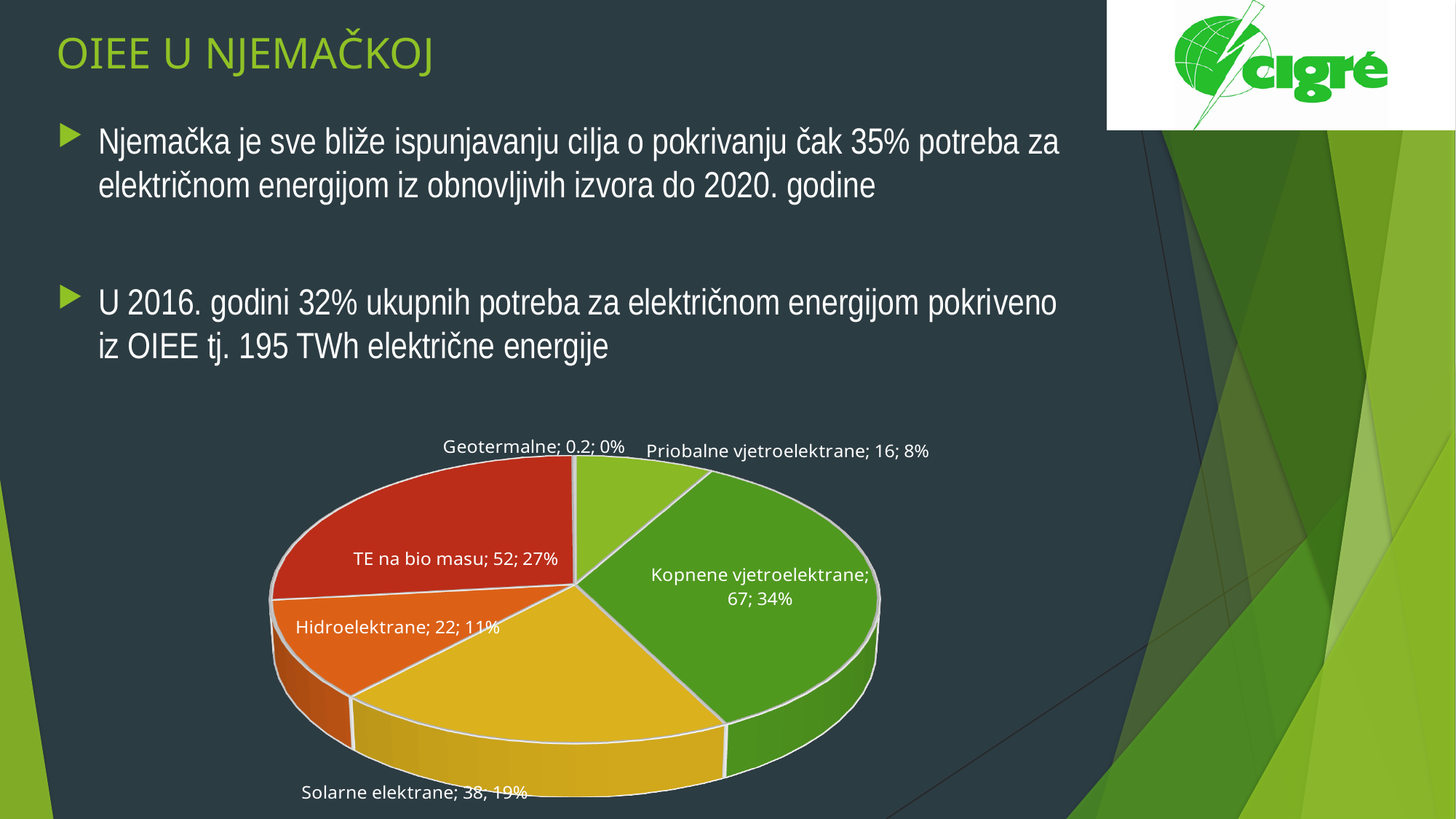
How many categories does the pie chart show? 6 What is the value for Hidroelektrane in the pie chart? 22 What is the value for TE na bio masu in the pie chart? 52 What is the difference between the values for Kopnene vjetroelektrane and Solarne elektrane? 29 Which category has the largest slice in the pie chart? Kopnene vjetroelektrane Which category has the smallest slice in the pie chart? Geotermalne What share of the pie does Solarne elektrane represent? 19% Which is larger, the value for TE na bio masu or the value for Hidroelektrane? TE na bio masu What kind of chart is shown on the slide? pie chart What share of the pie does Priobalne vjetroelektrane represent? 8% What is the value for Kopnene vjetroelektrane in the pie chart? 67 What is the value for Geotermalne in the pie chart? 0.2